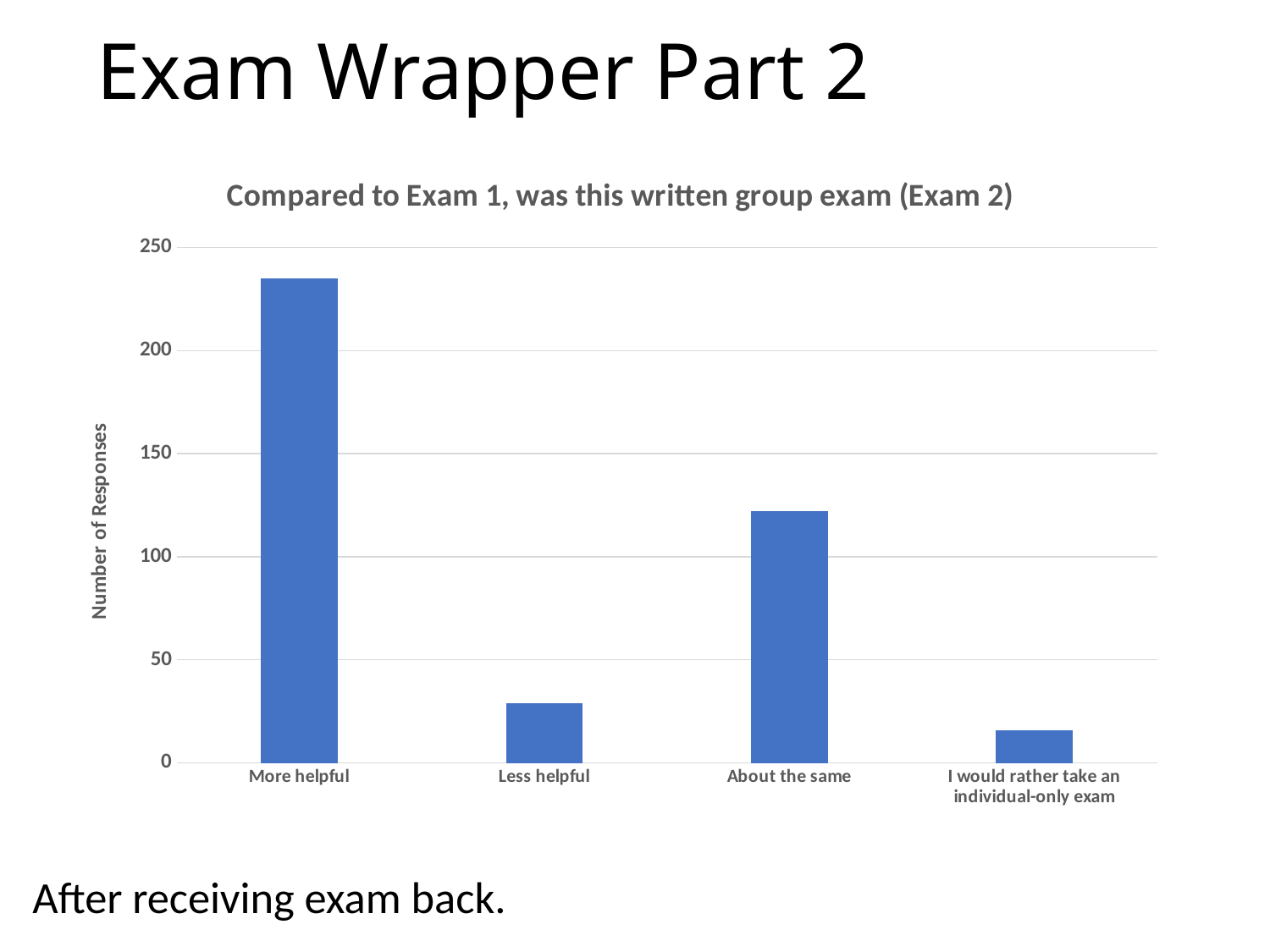
How many categories are shown on the x axis? 4 Is the value for More helpful greater or less than 200? greater Which category has the highest number of responses? More helpful Which has more responses, Less helpful or I would rather take an individual-only exam? Less helpful Which category has the lowest number of responses? I would rather take an individual-only exam What kind of chart is shown on the slide? bar chart Which has more responses, About the same or Less helpful? About the same Is the value for About the same greater or less than 100? greater What is the title of the chart? Compared to Exam 1, was this written group exam (Exam 2) Is the value for Less helpful greater or less than 50? less What is the label of the vertical axis? Number of Responses